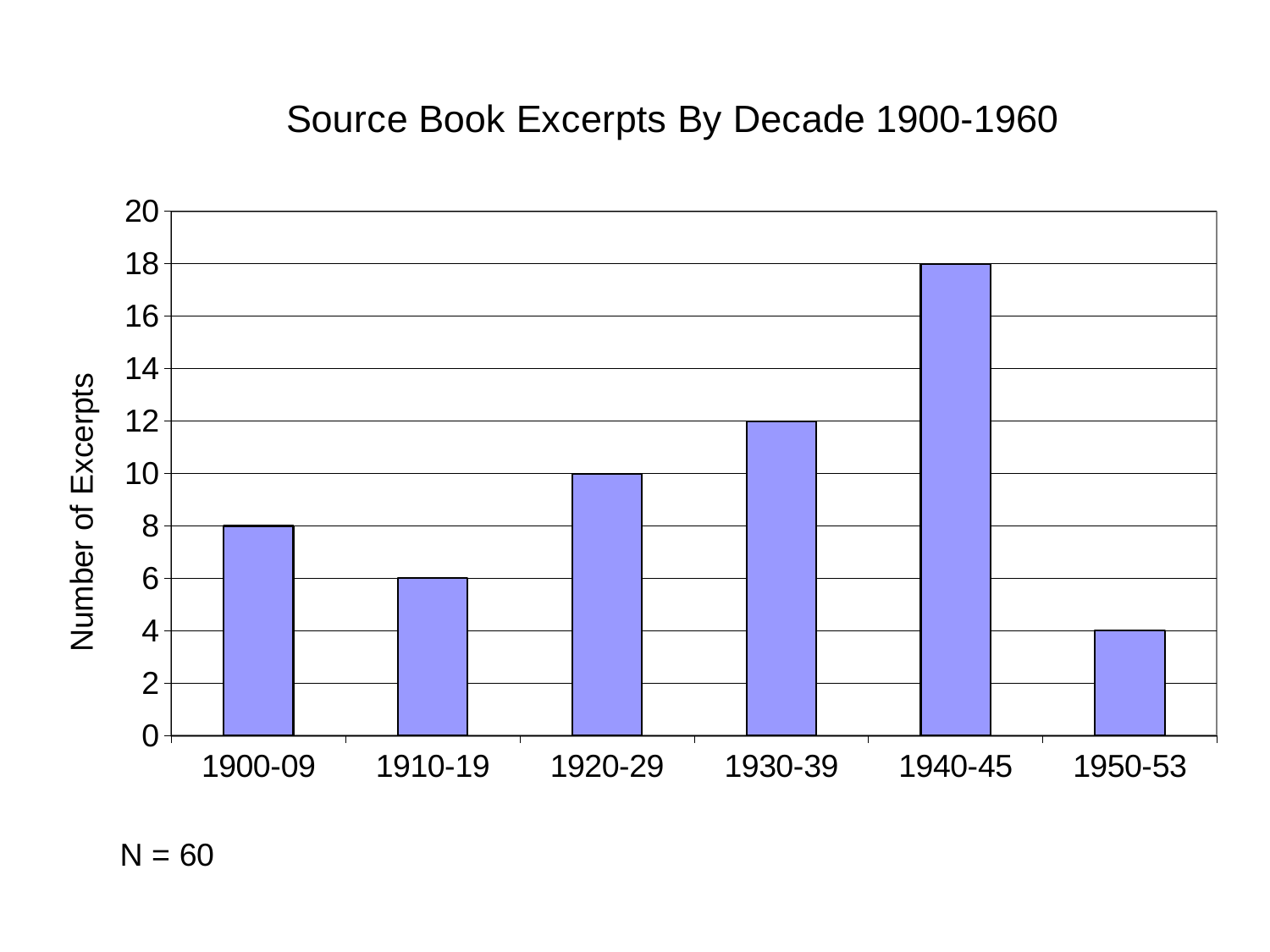
What is the difference in number of excerpts between 1940-45 and 1930-39? 6 Which decade has the lowest number of excerpts? 1950-53 Which has more excerpts, 1920-29 or 1910-19? 1920-29 What is the title of the chart? Source Book Excerpts By Decade 1900-1960 How many decade categories are shown on the x axis? 6 What is the number of excerpts for 1900-09? 8 What kind of chart is shown on the slide? bar chart Which decade has the highest number of excerpts? 1940-45 What is the number of excerpts for 1950-53? 4 What is the label of the y axis? Number of Excerpts Is the value for 1930-39 greater or less than 10? greater What is the number of excerpts for 1940-45? 18